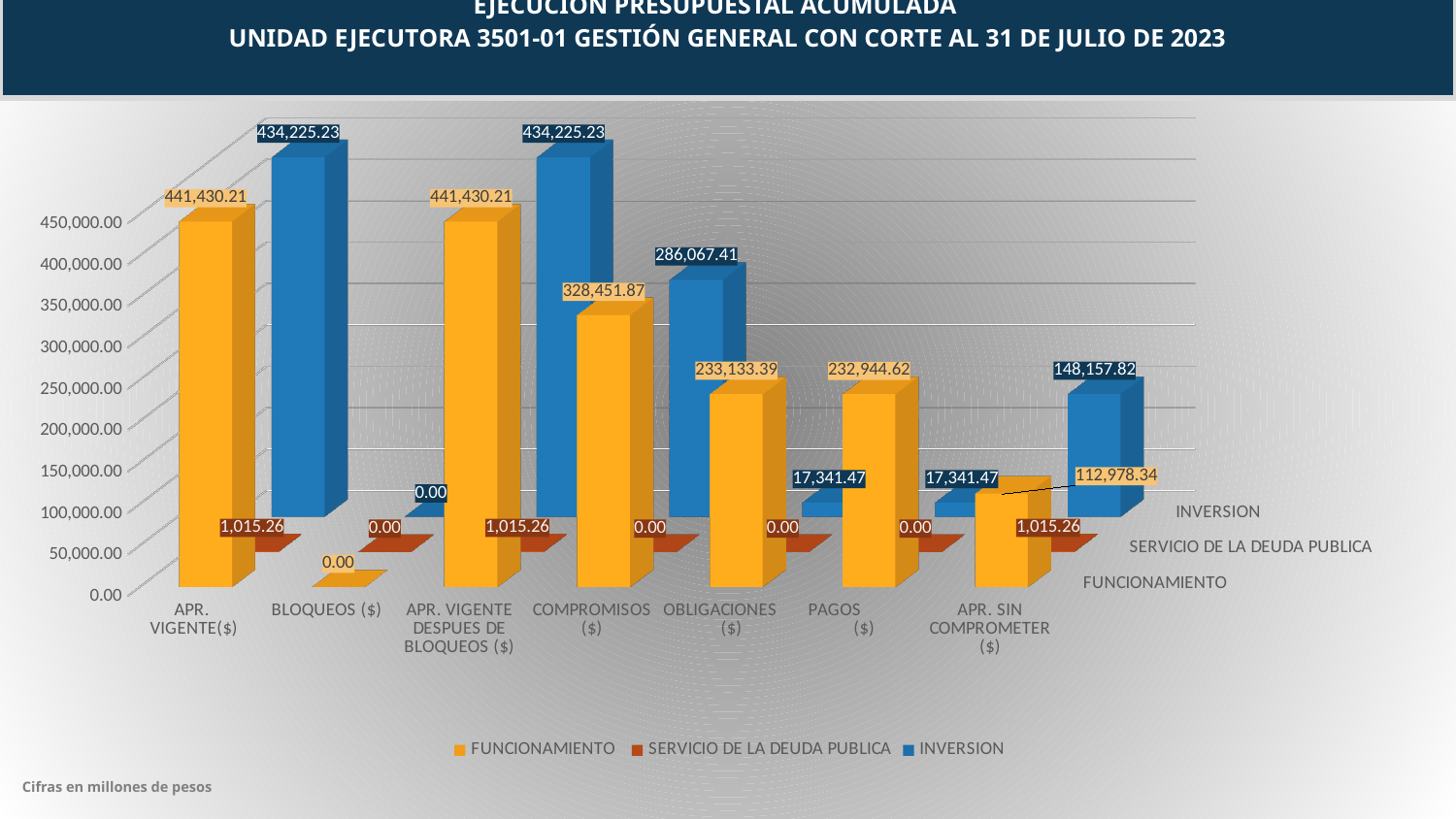
How many categories are shown on the x axis? 7 For APR. SIN COMPROMETER ($), which is larger: FUNCIONAMIENTO or INVERSION? INVERSION What is the SERVICIO DE LA DEUDA PUBLICA value for APR. VIGENTE($)? 1,015.26 What is the difference between the FUNCIONAMIENTO and INVERSION values for COMPROMISOS ($)? 42,384.46 What is the FUNCIONAMIENTO value for PAGOS ($)? 232,944.62 Which category has the highest INVERSION value? APR. VIGENTE($) and APR. VIGENTE DESPUES DE BLOQUEOS ($) (both 434,225.23) According to the note at the bottom of the slide, in what units are the figures expressed? Millones de pesos What kind of chart is shown on the slide? Bar chart What is the INVERSION value for APR. SIN COMPROMETER ($)? 148,157.82 How many series does the legend list? 3 What is the FUNCIONAMIENTO value for COMPROMISOS ($)? 328,451.87 What is the INVERSION value for OBLIGACIONES ($)? 17,341.47